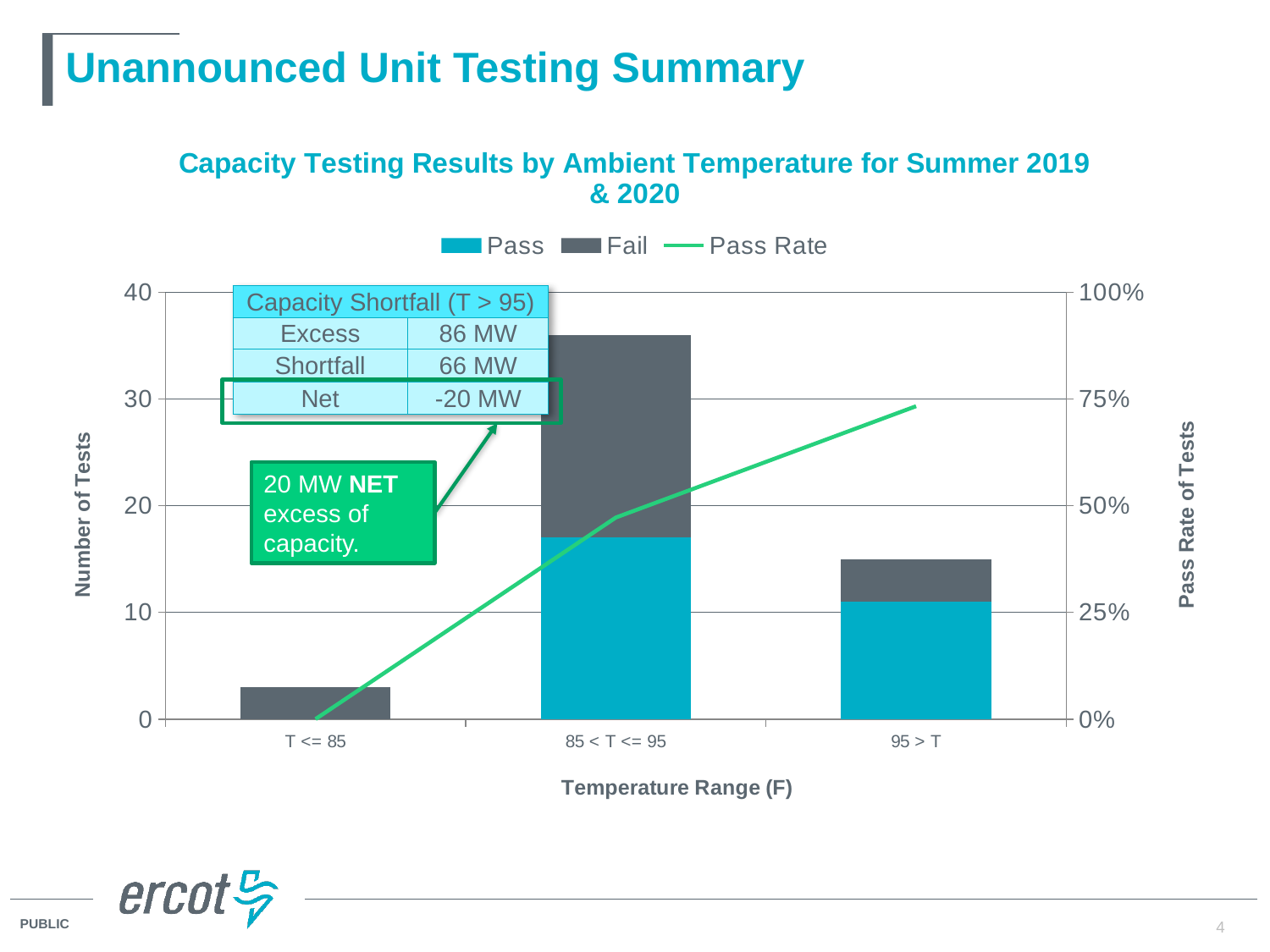
How many temperature range categories are shown on the x axis? 3 What kind of chart is shown on the slide? stacked bar chart with a line How many series does the legend list? 3 Is the total number of tests for T <= 85 greater or less than 10? less Which temperature range has the shortest stacked bar (fewest tests)? T <= 85 Is the total number of tests for 95 > T greater or less than 20? less Which temperature range has the tallest stacked bar (most tests)? 85 < T <= 95 What is the label of the left vertical axis? Number of Tests Is the total number of tests for 85 < T <= 95 greater or less than 30? greater Which has the higher Pass Rate, 85 < T <= 95 or 95 > T? 95 > T Does the Pass Rate line rise or fall as the temperature range increases along the x axis? rises